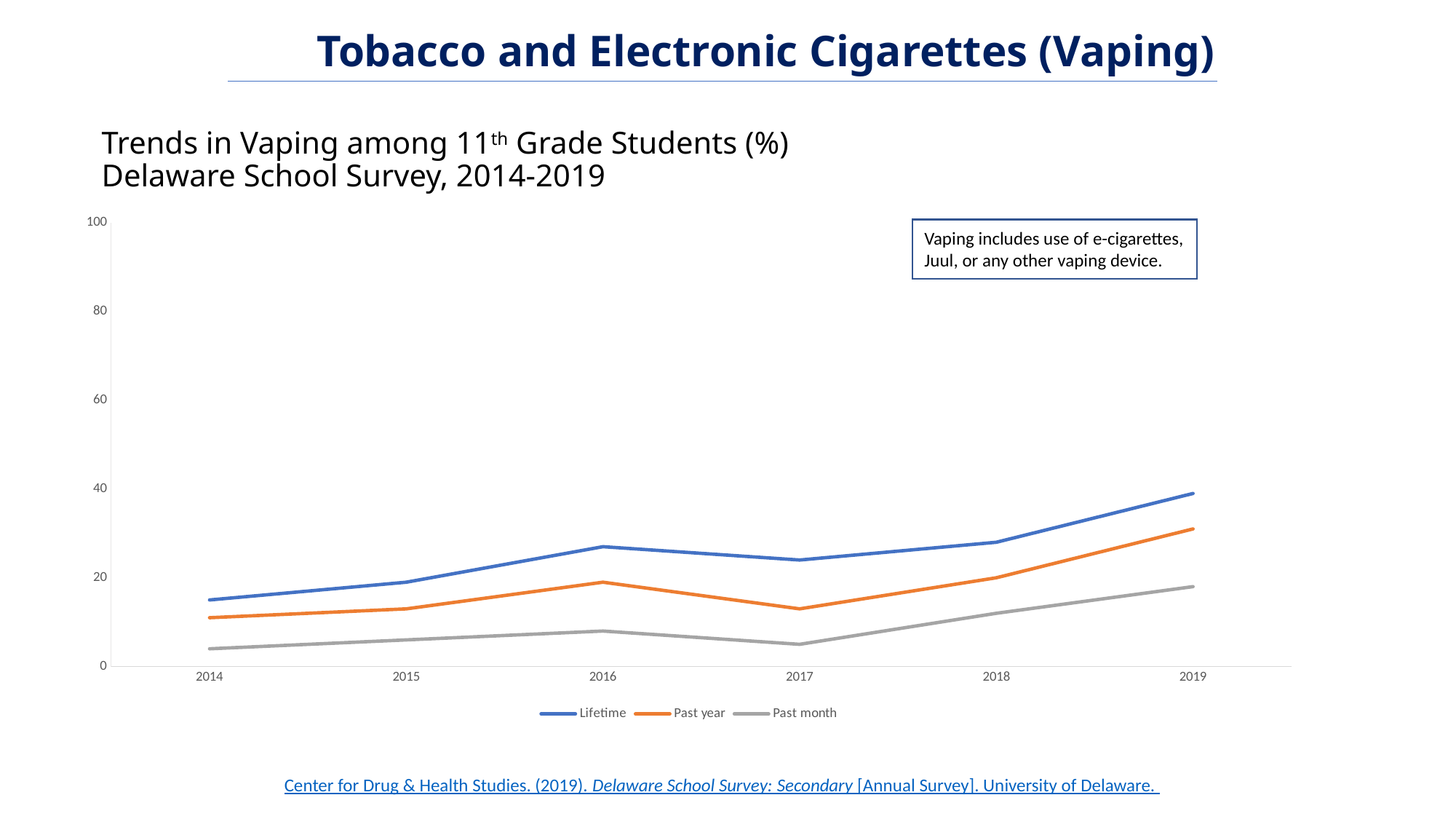
Do the Lifetime values generally rise or fall from 2014 to 2019? rise Which series has the highest values across all years? Lifetime In which year does the Lifetime series reach its highest value? 2019 Which series has the lowest values across all years? Past month Which is larger in 2019, the Lifetime value or the Past month value? Lifetime Is the Lifetime value for 2019 greater or less than 20? greater Is the Past year value for 2019 greater or less than 20? greater How many series does the legend list? 3 In which year is the Past month series at its lowest? 2014 What kind of chart is shown on the slide? line chart Is the Past month value for 2014 greater or less than 20? less How many years are plotted along the x axis? 6